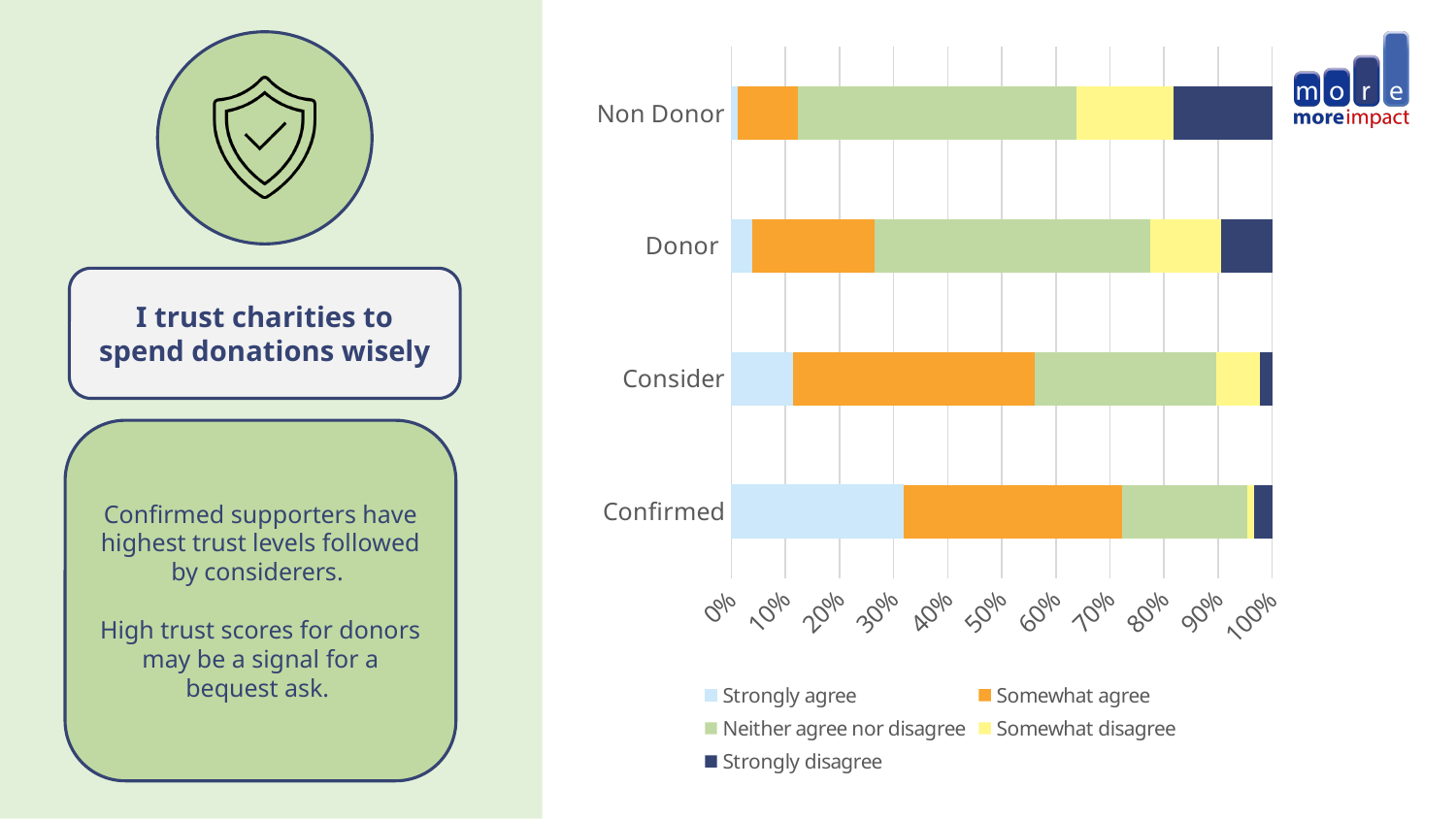
What statement is the chart measuring agreement with? I trust charities to spend donations wisely What kind of chart is shown on the slide? Stacked bar chart How many categories are plotted on the chart? 4 How many series does the legend list? 5 Which category has the smallest 'Strongly agree' segment? Non Donor Is the 'Somewhat agree' segment for Consider greater or less than 40%? greater Which is larger: the 'Somewhat agree' segment for Donor or the 'Somewhat agree' segment for Consider? Consider Which category has the largest 'Strongly agree' segment? Confirmed Is the 'Neither agree nor disagree' segment for Donor greater or less than 40%? greater Is the 'Strongly agree' segment for Confirmed greater or less than 20%? greater Which category has the largest 'Strongly disagree' segment? Non Donor What colour represents 'Strongly disagree' in the legend? Dark blue